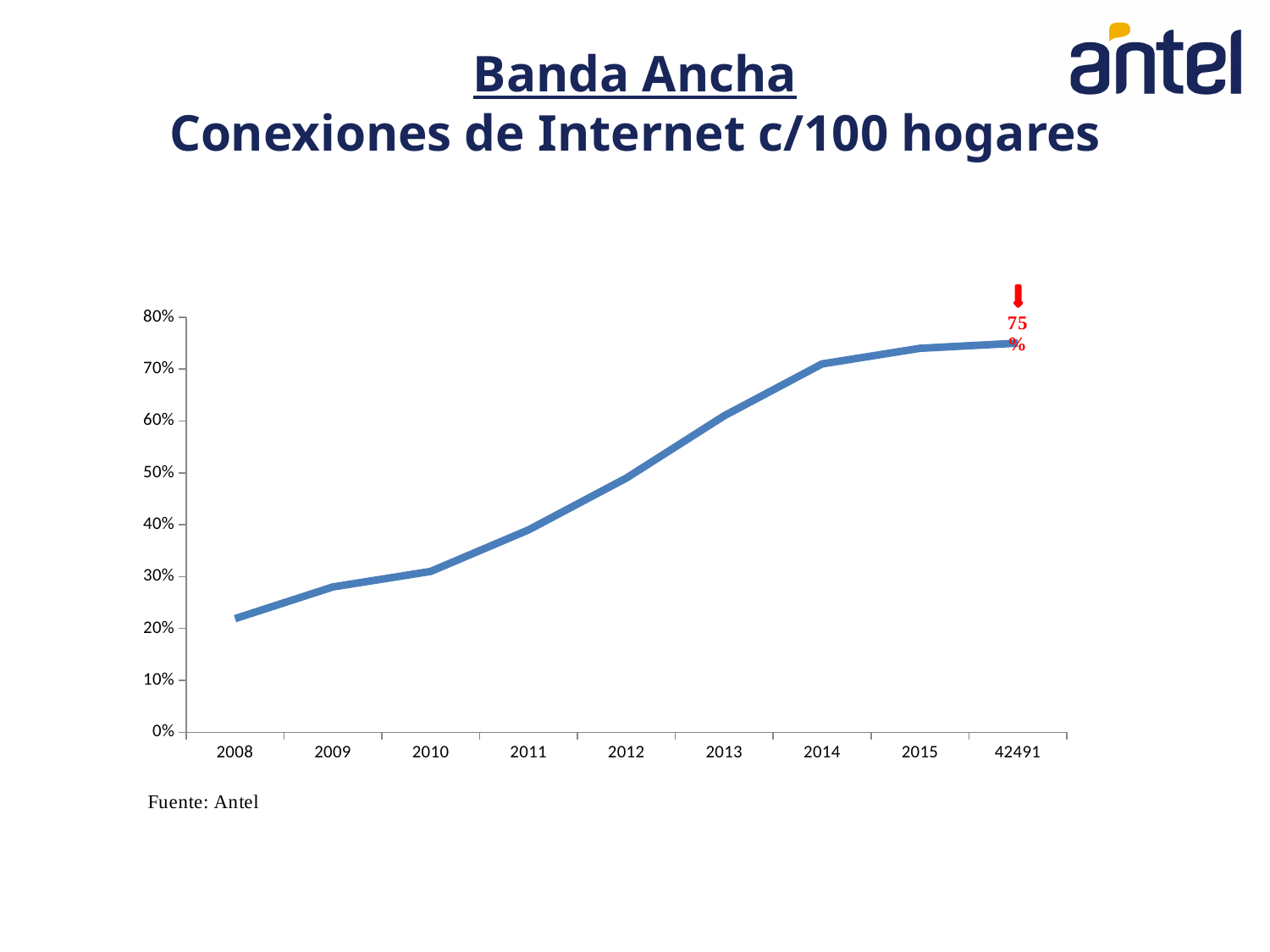
Is the value for 2008 greater or less than 30%? less How many data points are plotted along the x axis? 9 What source is cited below the chart? Antel Which is larger, the value for 2010 or the value for 2013? 2013 What kind of chart is shown on the slide? line chart Which x-axis category has the highest value? 42491 Is the value for 2012 greater or less than 40%? greater Which x-axis category has the lowest value? 2008 Do the values rise or fall from 2008 to 2015? rise What value is labelled for the last point (42491) on the chart? 75%